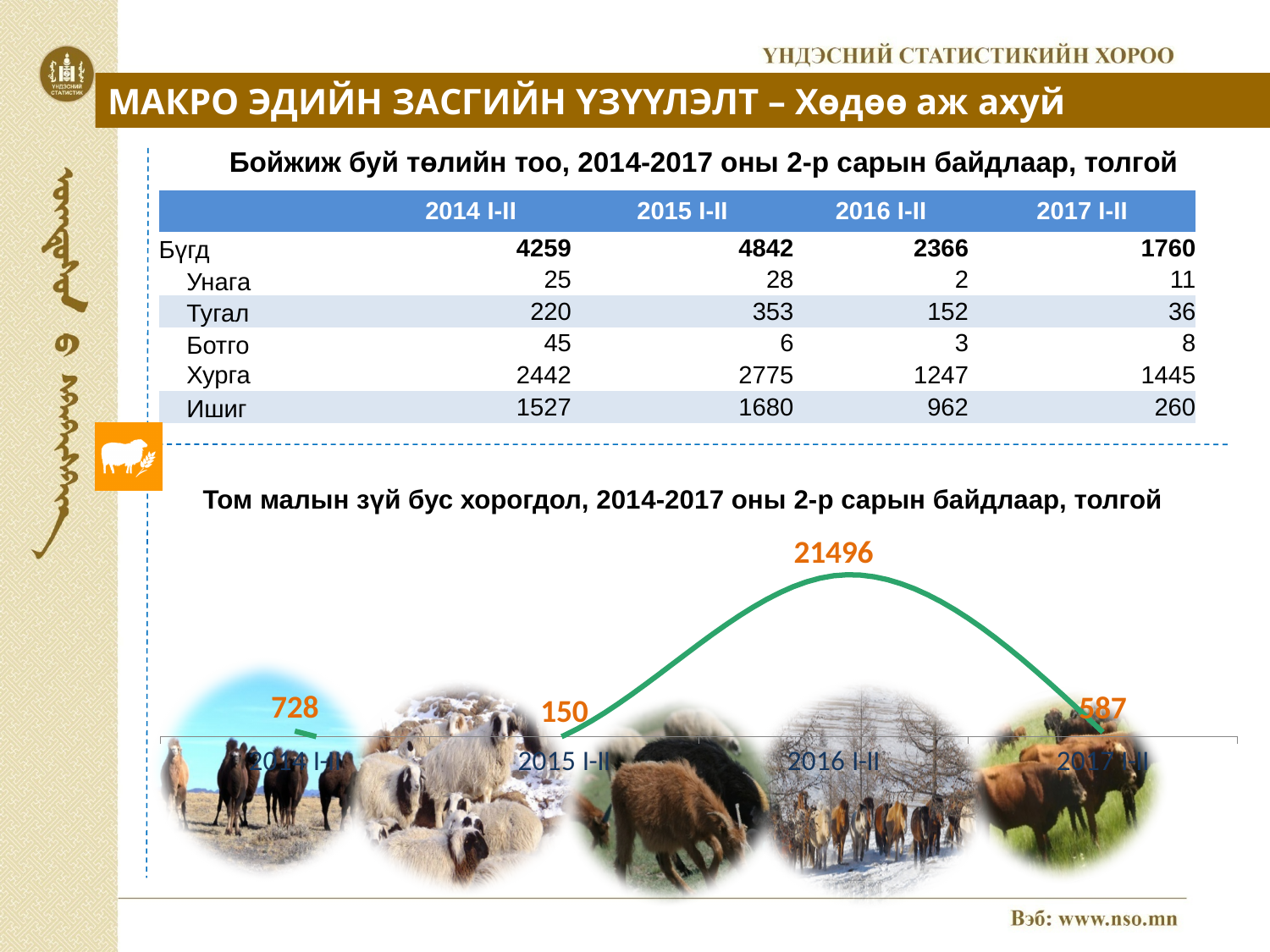
In the chart 'Том малын зүй бус хорогдол', what is the value for 2014 I-II? 728 In the chart 'Том малын зүй бус хорогдол', which period has the lowest value? 2015 I-II What kind of chart is 'Том малын зүй бус хорогдол, 2014-2017 оны 2-р сарын байдлаар, толгой'? line chart In the chart 'Том малын зүй бус хорогдол, 2014-2017 оны 2-р сарын байдлаар, толгой', what is the value for 2016 I-II? 21496 How many periods are plotted in the chart 'Том малын зүй бус хорогдол'? 4 In the chart 'Том малын зүй бус хорогдол', which period has the highest value? 2016 I-II In the chart 'Том малын зүй бус хорогдол', what is the difference between the values for 2014 I-II and 2015 I-II? 578 In the chart 'Том малын зүй бус хорогдол', what is the value for 2017 I-II? 587 In the chart 'Том малын зүй бус хорогдол', does the value rise or fall from 2016 I-II to 2017 I-II? fall In the chart 'Том малын зүй бус хорогдол', which is larger, the value for 2014 I-II or 2017 I-II? 2014 I-II In the chart 'Том малын зүй бус хорогдол', what is the value for 2015 I-II? 150 In the chart 'Том малын зүй бус хорогдол', what is the difference between the values for 2016 I-II and 2017 I-II? 20909